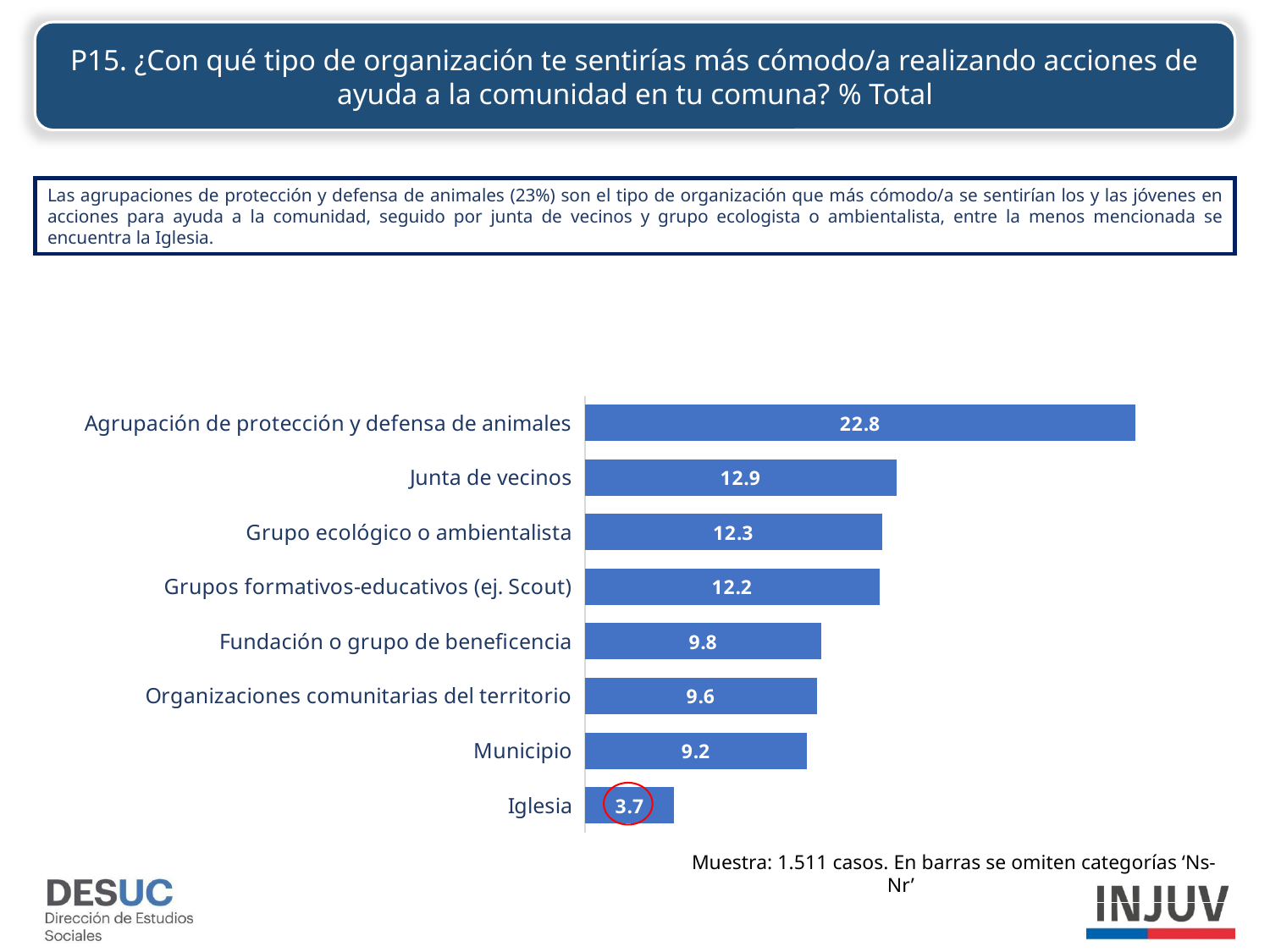
Which category has the lowest value? Iglesia Which category has the highest value? Agrupación de protección y defensa de animales What is the difference between the values for Agrupación de protección y defensa de animales and Junta de vecinos? 9.9 What kind of chart is shown on the slide? Bar chart What is the value for Agrupación de protección y defensa de animales? 22.8 How many categories are shown in the chart? 8 Which is larger, the value for Fundación o grupo de beneficencia or the value for Municipio? Fundación o grupo de beneficencia What is the value for Junta de vecinos? 12.9 What is the difference between the values for Municipio and Iglesia? 5.5 What is the value for Iglesia? 3.7 Which category's data label is circled in red on the chart? Iglesia What is the value for Municipio? 9.2